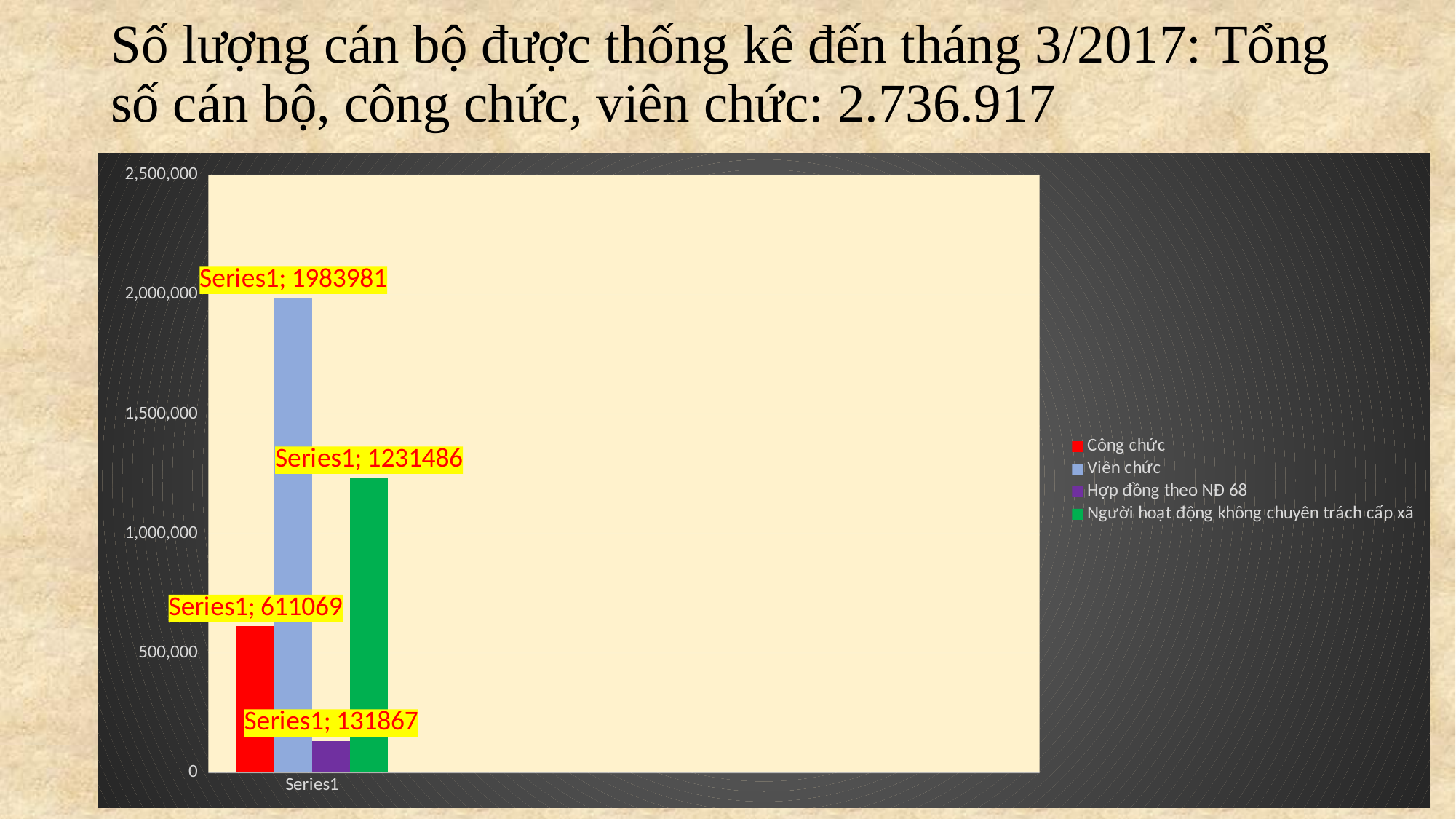
What is the difference between the values for Viên chức and Người hoạt động không chuyên trách cấp xã? 752495 What value is shown for Công chức? 611069 What kind of chart is shown on the slide? bar chart Is the value for Công chức greater or less than 500,000? greater What is the difference between the values for Công chức and Hợp đồng theo NĐ 68? 479202 Which category has the lowest value? Hợp đồng theo NĐ 68 Which is larger, the value for Công chức or the value for Người hoạt động không chuyên trách cấp xã? Người hoạt động không chuyên trách cấp xã What value is shown for Viên chức? 1983981 Which category has the highest value? Viên chức What value is shown for Hợp đồng theo NĐ 68? 131867 How many entries does the legend list? 4 What value is shown for Người hoạt động không chuyên trách cấp xã? 1231486